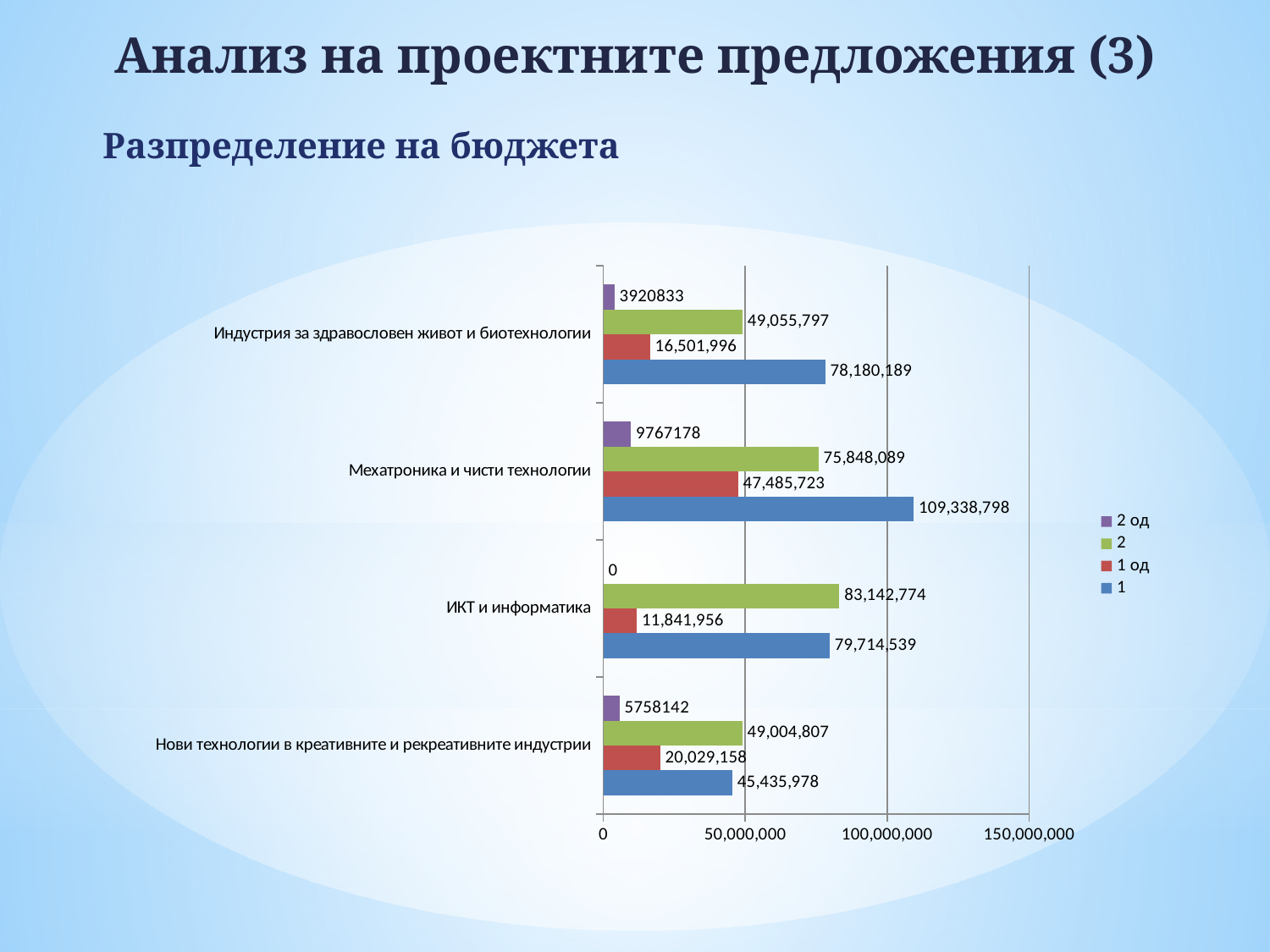
What kind of chart is shown on the slide? Bar chart What is the value of series "2" for ИКТ и информатика? 83,142,774 How many categories are shown on the chart? 4 Which category has the highest value for series "1"? Мехатроника и чисти технологии What is the value of series "1 од" for Нови технологии в креативните и рекреативните индустрии? 20,029,158 Which category has the lowest value for series "2 од"? ИКТ и информатика What is the value of series "2 од" for Индустрия за здравословен живот и биотехнологии? 3920833 What is the difference between the series "1 од" values for Мехатроника и чисти технологии and Индустрия за здравословен живот и биотехнологии? 30,983,727 How many series does the legend list? 4 What is the value of series "1" for Мехатроника и чисти технологии? 109,338,798 For ИКТ и информатика, which is larger: the value of series "2" or series "1"? 2 What is the difference between the series "1" values for Мехатроника и чисти технологии and Индустрия за здравословен живот и биотехнологии? 31,158,609